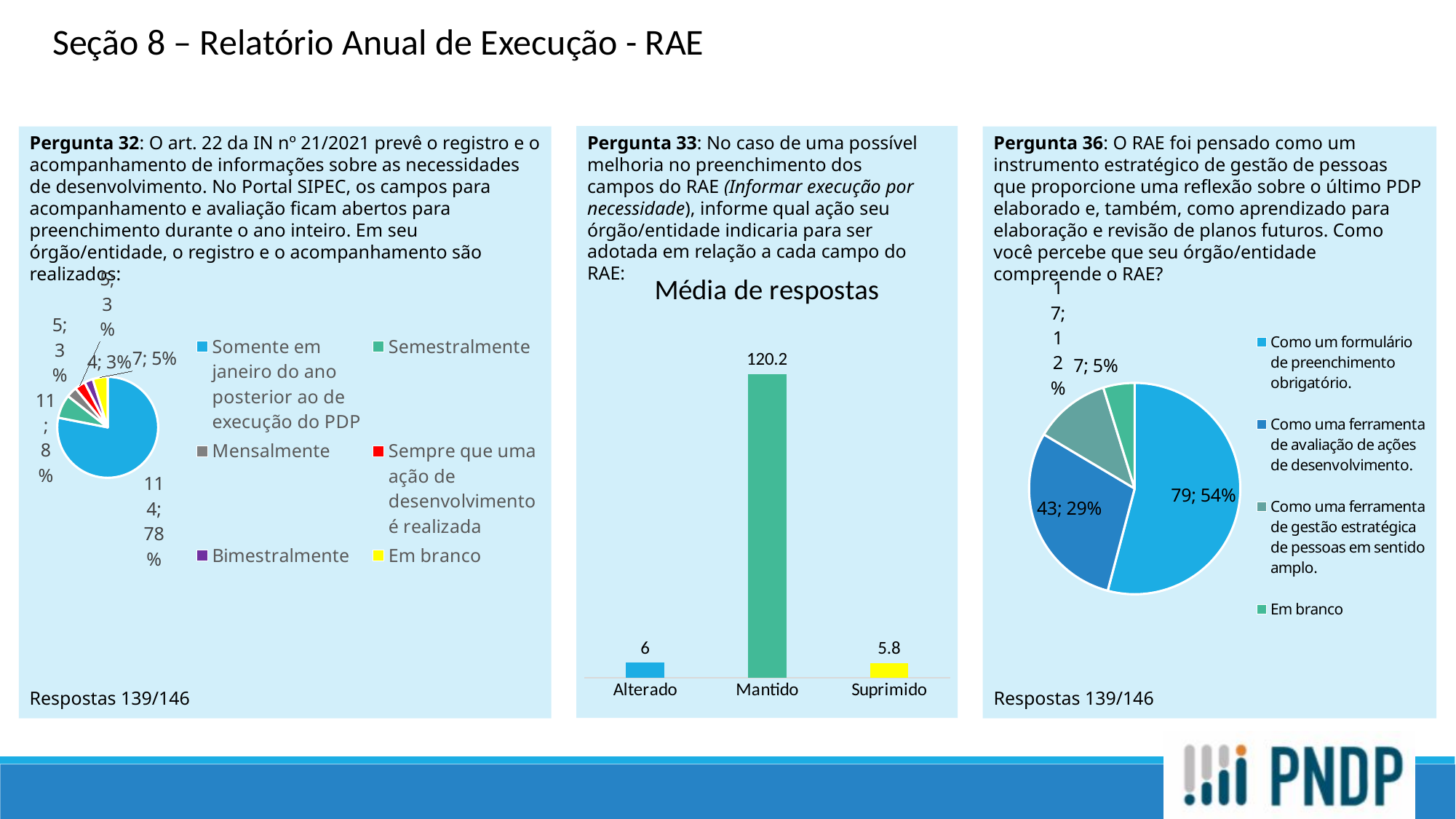
In the 'Média de respostas' chart, what is the value for Mantido? 120.2 In the Pergunta 36 pie chart on the right, how many entries does the legend list? 4 In the 'Média de respostas' chart, what is the difference between Mantido and Alterado? 114.2 In the Pergunta 32 pie chart on the left, how many entries does the legend list? 6 In the 'Média de respostas' chart, what is the value for Suprimido? 5.8 In the Pergunta 36 pie chart on the right, what is the value and share for 'Como um formulário de preenchimento obrigatório.'? 79; 54% In the Pergunta 36 pie chart on the right, what share does 'Como uma ferramenta de avaliação de ações de desenvolvimento.' have? 29% In the 'Média de respostas' chart, what is the value for Alterado? 6 In the 'Média de respostas' chart, which category has the highest value? Mantido In the 'Média de respostas' chart, how many categories are shown? 3 In the Pergunta 32 pie chart on the left, what is the value and share of the largest slice, 'Somente em janeiro do ano posterior ao de execução do PDP'? 114; 78% What kind of chart is the 'Média de respostas' chart? bar chart